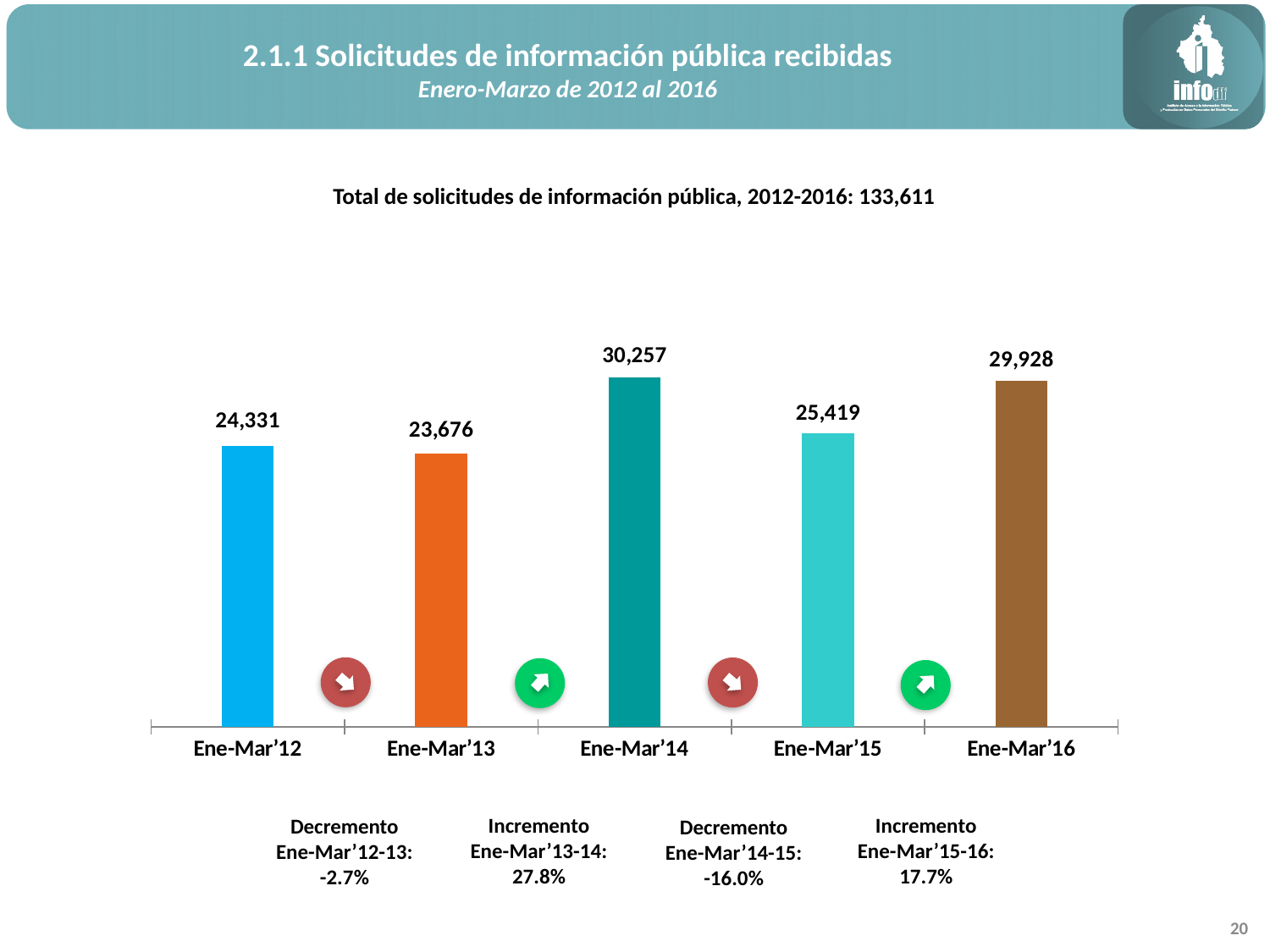
Does the value rise or fall from Ene-Mar'14 to Ene-Mar'15? Fall Which is larger, the value for Ene-Mar'12 or Ene-Mar'13? Ene-Mar'12 Which period has the highest value? Ene-Mar'14 Which period has the lowest value? Ene-Mar'13 What is the value for Ene-Mar'16? 29,928 What total of solicitudes de información pública for 2012-2016 is stated on the slide? 133,611 What is the value for Ene-Mar'12? 24,331 What is the value for Ene-Mar'14? 30,257 What is the difference between the values for Ene-Mar'14 and Ene-Mar'15? 4,838 How many periods are shown on the x axis? 5 What kind of chart is shown on the slide? Bar chart What is the difference between the values for Ene-Mar'16 and Ene-Mar'15? 4,509